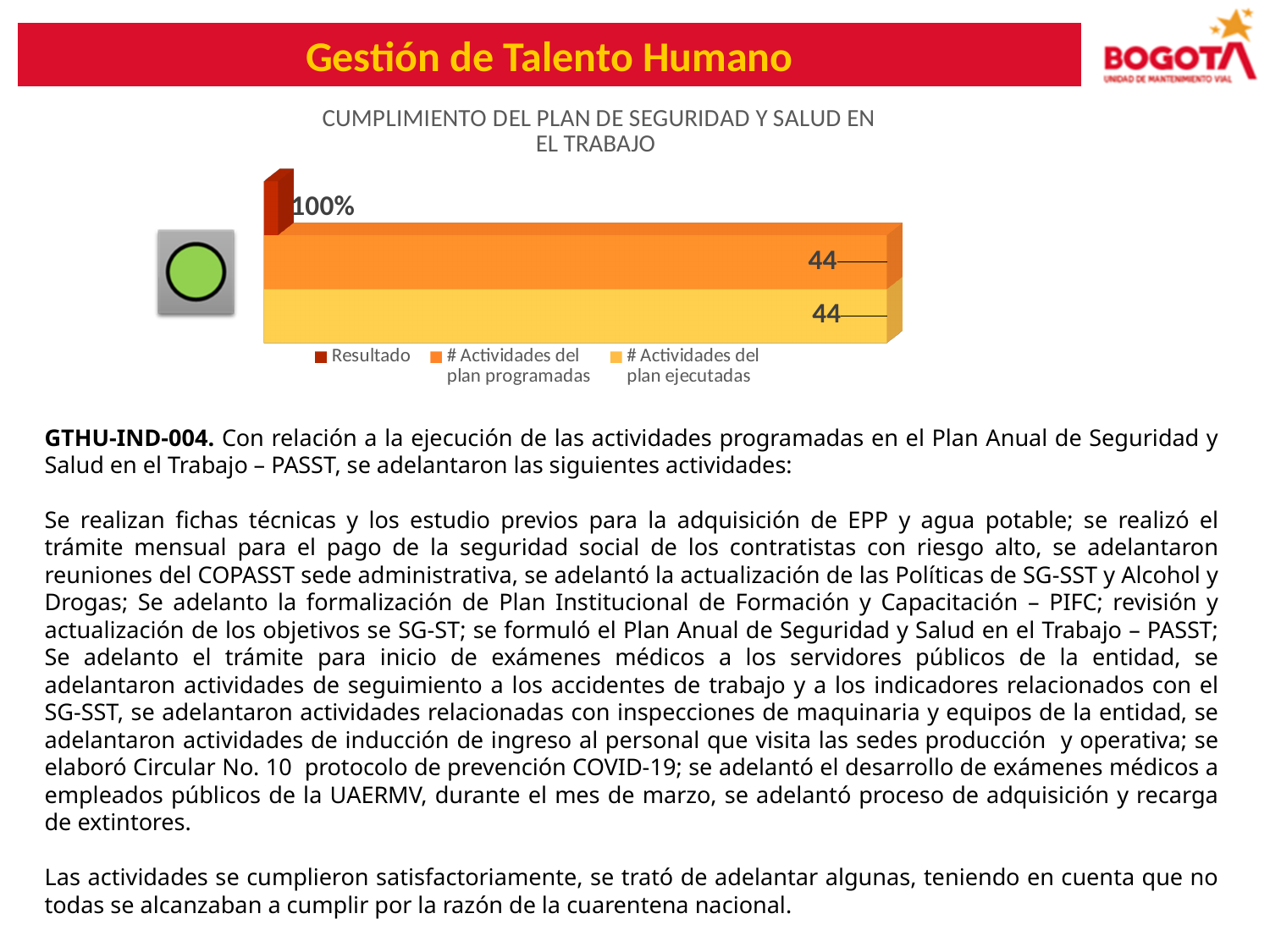
Which series is shown in yellow in the legend? # Actividades del plan ejecutadas How many series does the legend list? 3 What is the value of the '# Actividades del plan programadas' series? 44 What is the value of the '# Actividades del plan ejecutadas' series? 44 What kind of chart is shown on the slide? Bar chart What is the difference between the number of activities programmed and the number of activities executed? 0 Are the bars in the chart oriented horizontally or vertically? Horizontally What is the title of the chart? CUMPLIMIENTO DEL PLAN DE SEGURIDAD Y SALUD EN EL TRABAJO What value is shown for the 'Resultado' series? 100%